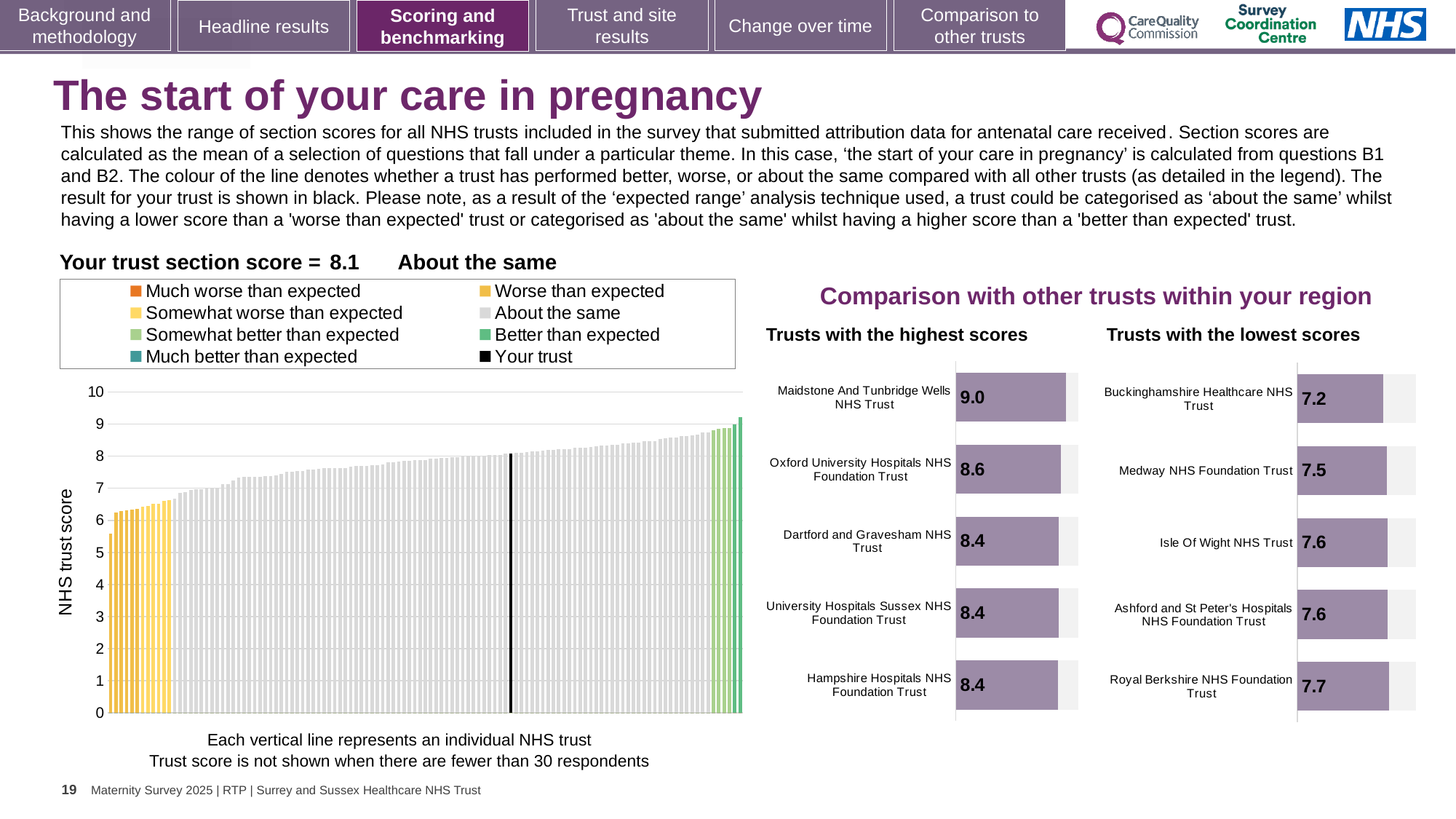
In the 'Trusts with the lowest scores' chart, which trust has the lowest score? Buckinghamshire Healthcare NHS Trust In the 'Trusts with the lowest scores' chart, what is the score for Buckinghamshire Healthcare NHS Trust? 7.2 In the 'Trusts with the lowest scores' chart, what is the difference between the scores of Royal Berkshire NHS Foundation Trust and Buckinghamshire Healthcare NHS Trust? 0.5 In the 'Trusts with the lowest scores' chart, which has the higher score: Medway NHS Foundation Trust or Isle Of Wight NHS Trust? Isle Of Wight NHS Trust What is the section score for your trust shown on the slide? 8.1 In the 'Trusts with the highest scores' chart, which trust has the highest score? Maidstone And Tunbridge Wells NHS Trust In the 'NHS trust score' chart on the left, do the values rise or fall from left to right? Rise In the 'Trusts with the highest scores' chart, what is the difference between the scores of Maidstone And Tunbridge Wells NHS Trust and Oxford University Hospitals NHS Foundation Trust? 0.4 What kind of chart is the large 'NHS trust score' chart on the left of the slide? Bar chart How many entries does the legend above the 'NHS trust score' chart list? 8 How many trusts are shown in the 'Trusts with the highest scores' chart? 5 In the 'Trusts with the highest scores' chart, what is the score for Maidstone And Tunbridge Wells NHS Trust? 9.0